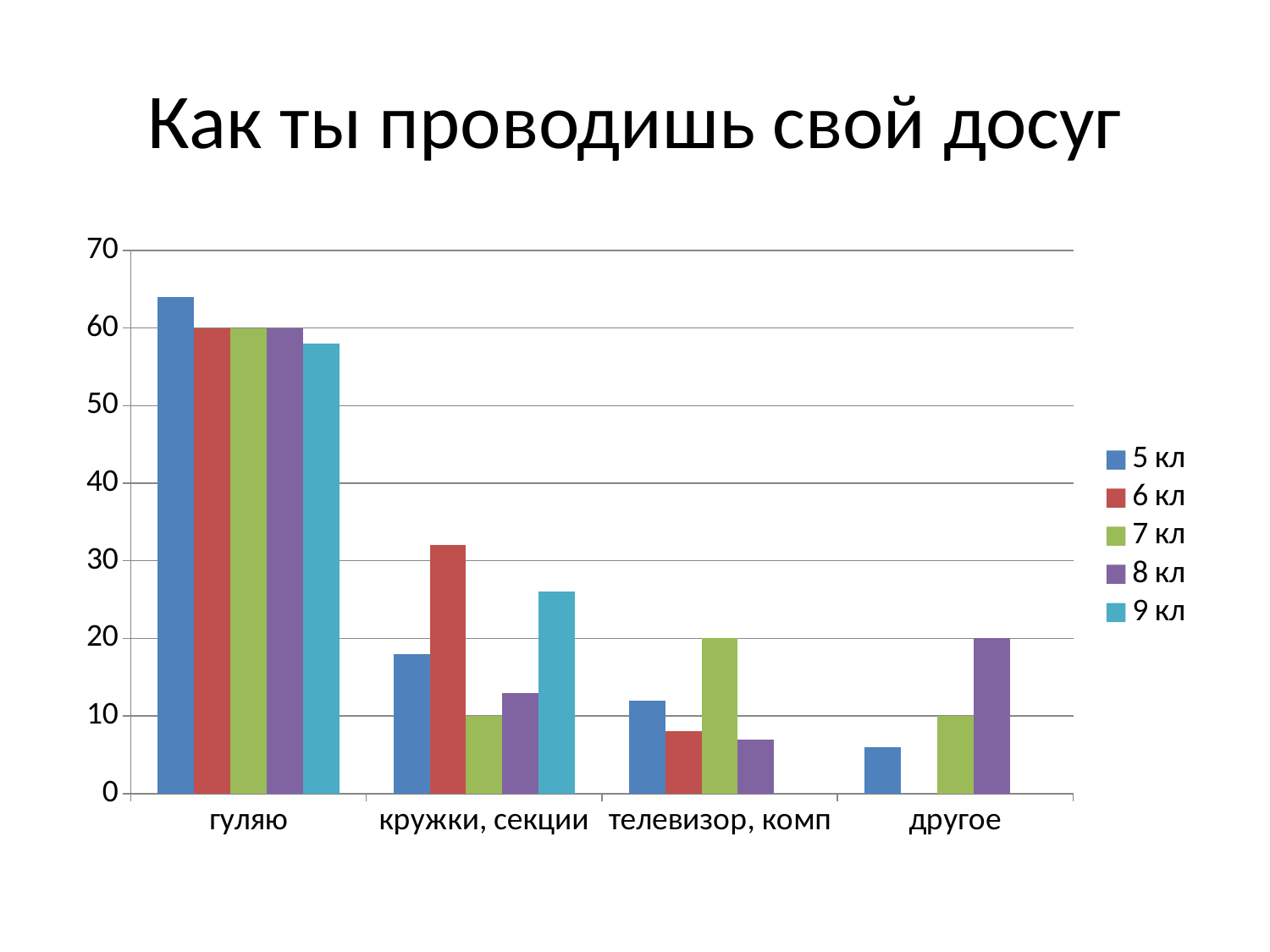
Which series has the highest value for "кружки, секции"? 6 кл What kind of chart is shown on the slide? bar chart Which series has the highest value for "гуляю"? 5 кл How many series does the legend list? 5 What is the title of the chart? Как ты проводишь свой досуг For "кружки, секции", which is larger: the value for 6 кл or the value for 9 кл? 6 кл Which category has the highest values overall across all series? гуляю Is the value for 5 кл in "другое" greater or less than 10? less How many categories are shown on the x axis? 4 Which series has the lowest value for "кружки, секции"? 7 кл Is the value for 5 кл in "гуляю" greater or less than 60? greater Is the value for 6 кл in "кружки, секции" greater or less than 30? greater